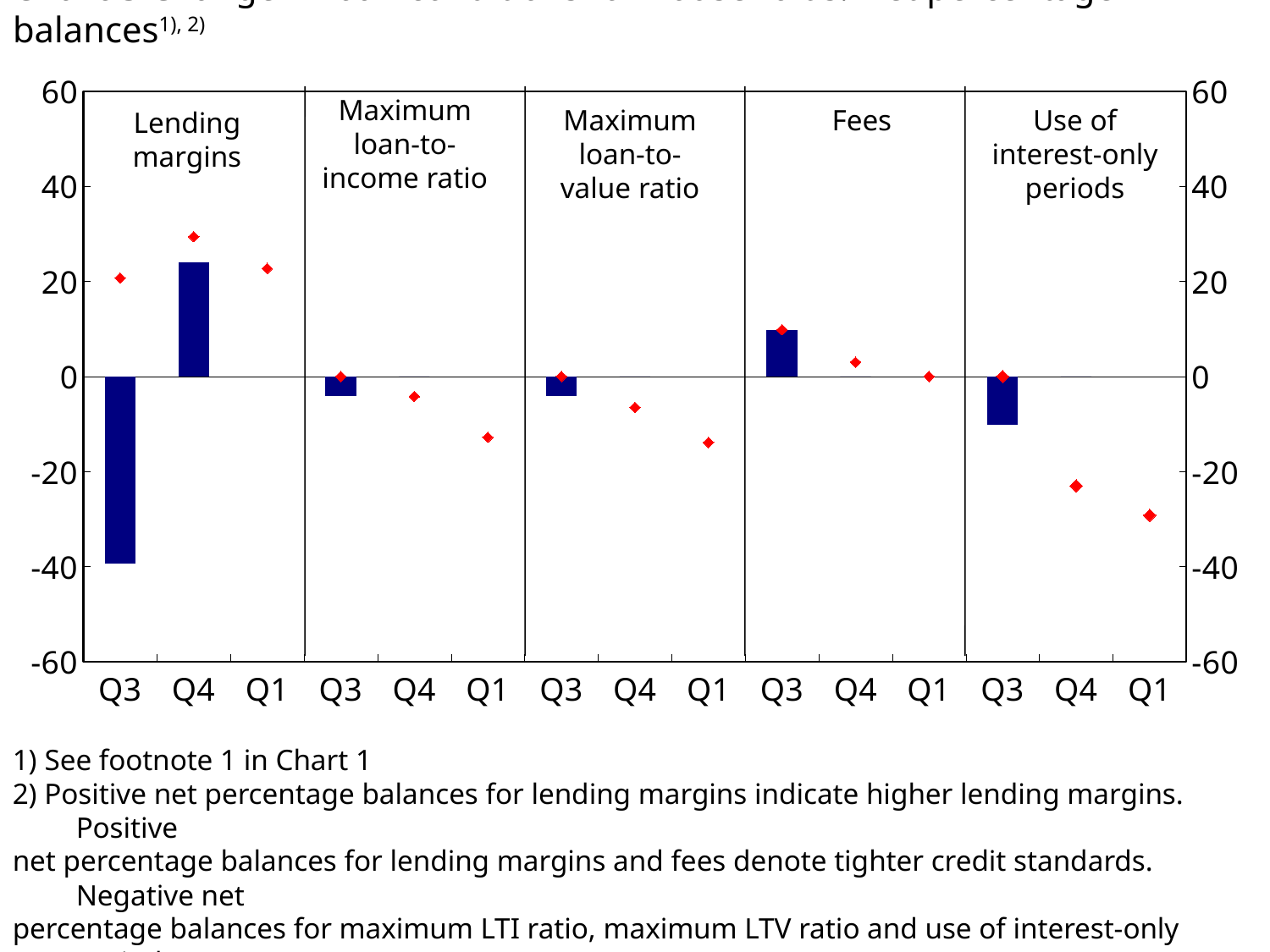
Is the Q3 bar in the Fees panel greater or less than 20? less What kind of chart is shown on the slide? combination bar and line chart (bars with red diamond markers) How many panels (credit standard categories) does the chart have? 5 Which is larger: the Q4 bar in the Lending margins panel or the Q3 bar in the Fees panel? Q4 bar in Lending margins How many quarters are shown on the x axis within each panel? 3 Is the Q3 bar in the Use of interest-only periods panel greater or less than 0? less In the Use of interest-only periods panel, do the red diamond markers rise or fall from Q3 to Q1? fall What are the minimum and maximum values shown on the vertical axis? -60 and 60 Is the Q4 bar in the Lending margins panel greater or less than 20? greater Which panel contains the highest bar in the chart? Lending margins Which panel contains the lowest (most negative) bar in the chart? Lending margins